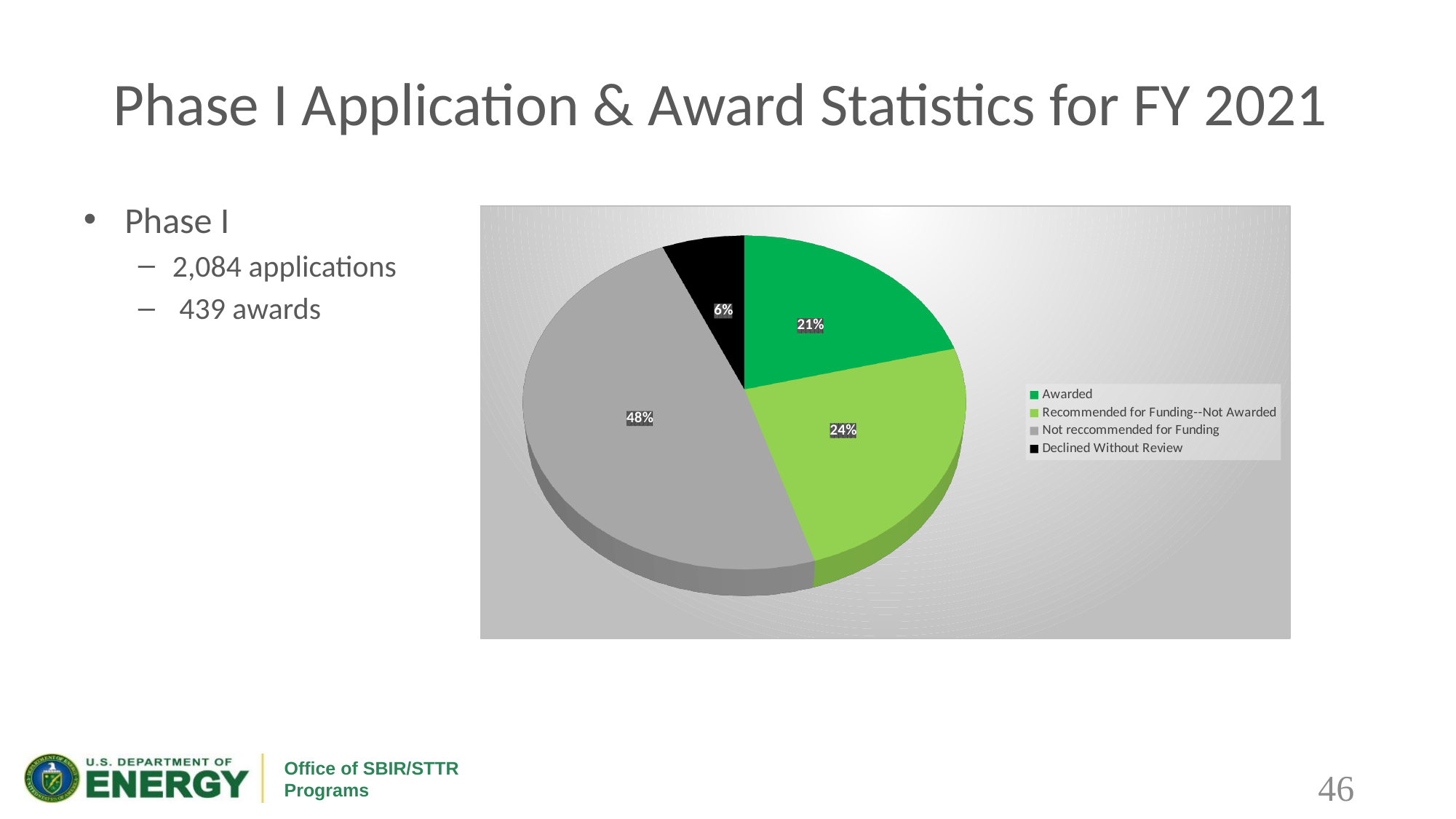
What percentage of applications were Not recommended for Funding? 48% What is the difference in percentage points between Not recommended for Funding and Awarded? 27 Which category has the largest share of the pie? Not recommended for Funding What percentage of applications were Declined Without Review? 6% What colour represents the Awarded slice? Green What percentage of Phase I applications were Awarded? 21% Which category has the smallest share of the pie? Declined Without Review What type of chart is shown on the slide? Pie chart What percentage of applications were Recommended for Funding--Not Awarded? 24% Which is larger: the share for Awarded or the share for Recommended for Funding--Not Awarded? Recommended for Funding--Not Awarded How many categories does the pie chart show? 4 What colour represents the Declined Without Review slice? Black